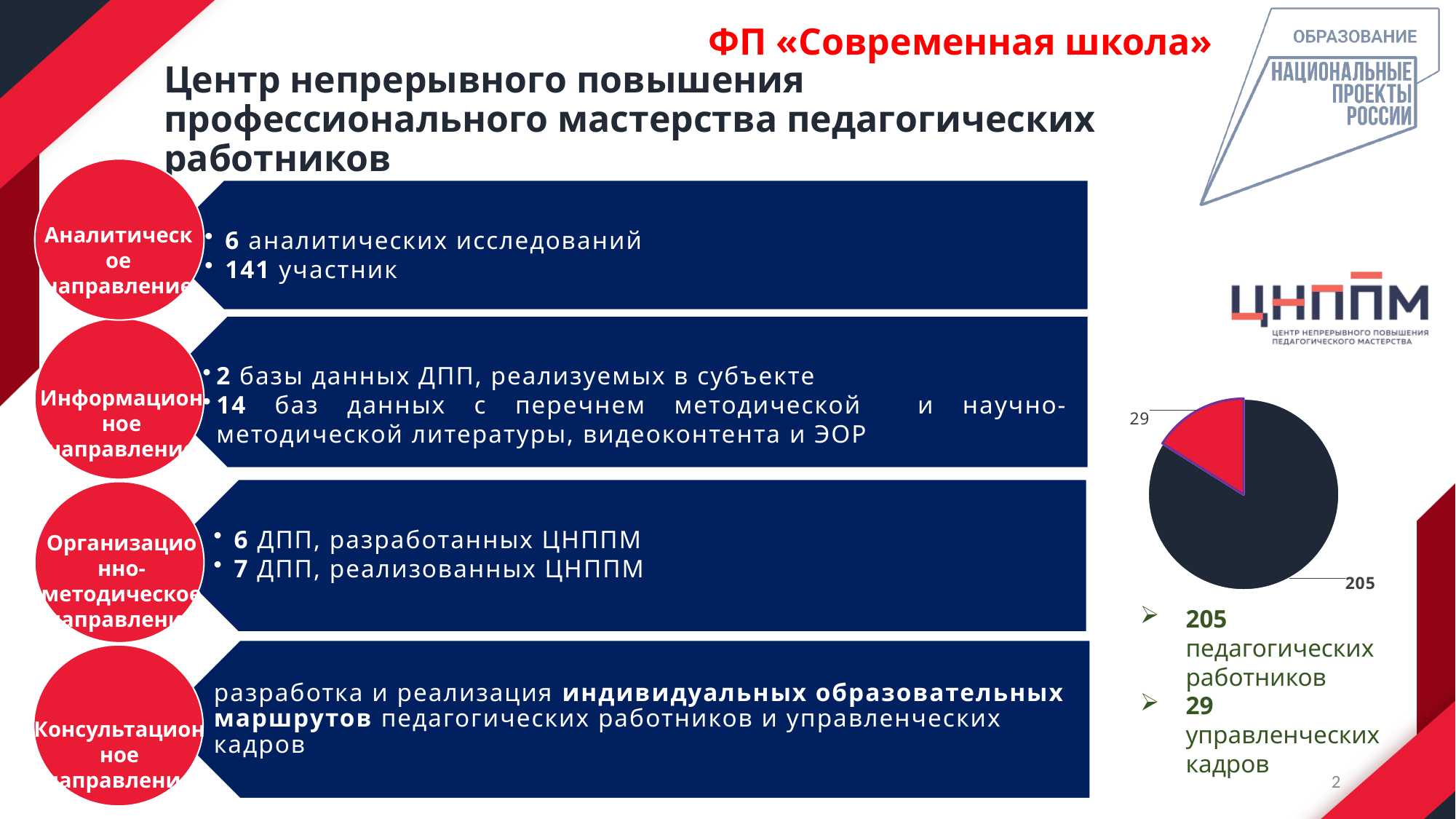
What value is shown for the red slice of the pie chart? 29 Is the value 205 or the value 29 larger in the pie chart? 205 What is the total of the two values shown in the pie chart? 234 How many slices does the pie chart have? 2 Which slice of the pie chart is the largest? 205 According to the text below the pie chart, what does the value 29 represent? управленческих кадров What is the difference between the two values in the pie chart, 205 and 29? 176 What value is shown for the dark slice of the pie chart? 205 According to the text below the pie chart, what does the value 205 represent? педагогических работников What kind of chart is shown on the right side of the slide? pie chart Which slice of the pie chart is the smallest? 29